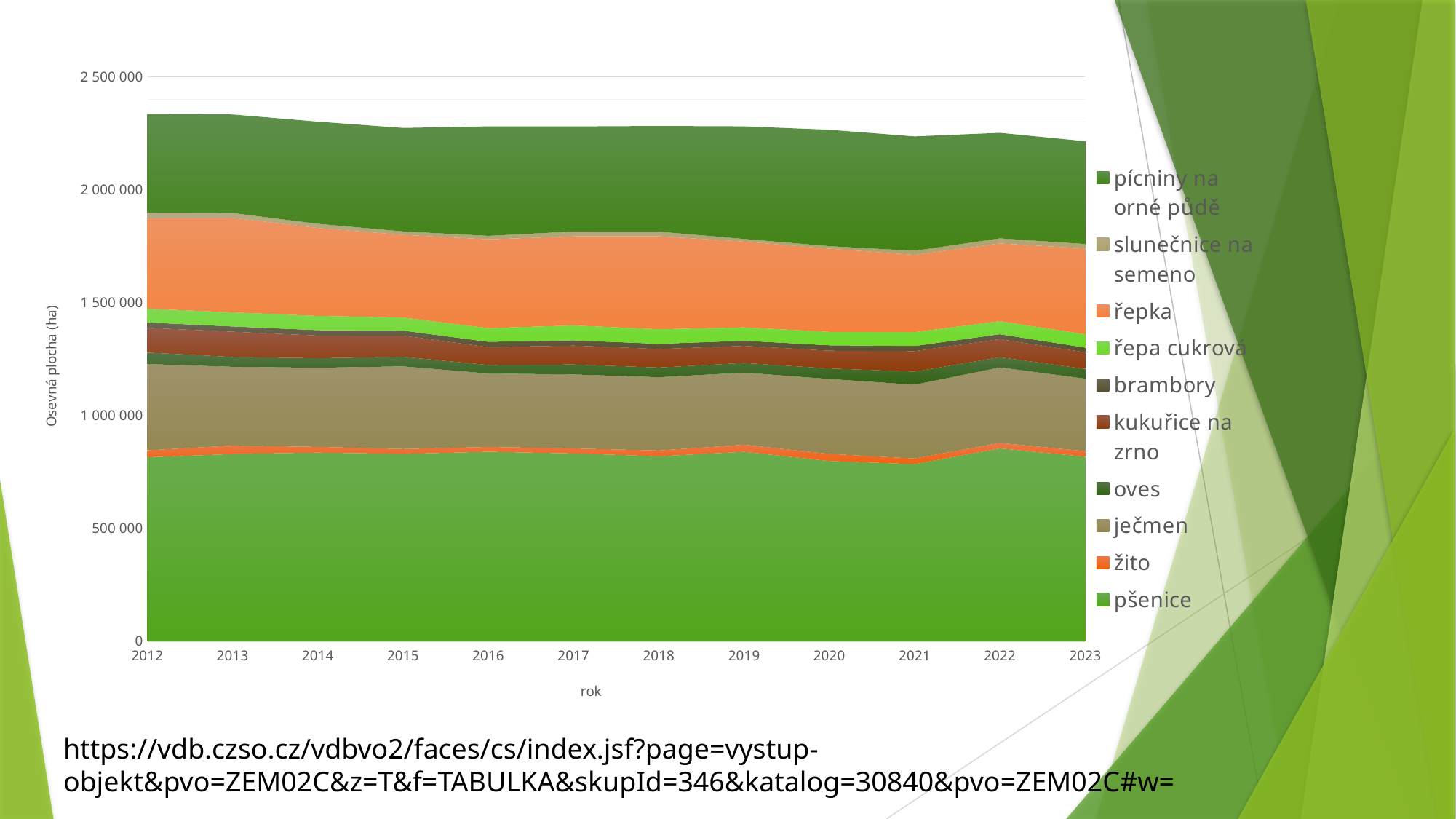
What kind of chart is shown on the slide? stacked area chart Is the value for pšenice in 2012 greater or less than 500 000? greater What is the label of the x axis? rok Is the total sown area (top of the stack) in 2023 greater or less than 2 500 000? less What is the label of the y axis? Osevná plocha (ha) In 2012, which is larger: the area for pšenice or the area for ječmen? pšenice Which series occupies the largest area of the chart? pšenice How many years are plotted along the x axis? 12 How many series does the legend list? 10 Does the total sown area (top of the stack) rise or fall from 2012 to 2023? fall Is the total sown area (top of the stack) in 2012 greater or less than 2 000 000? greater